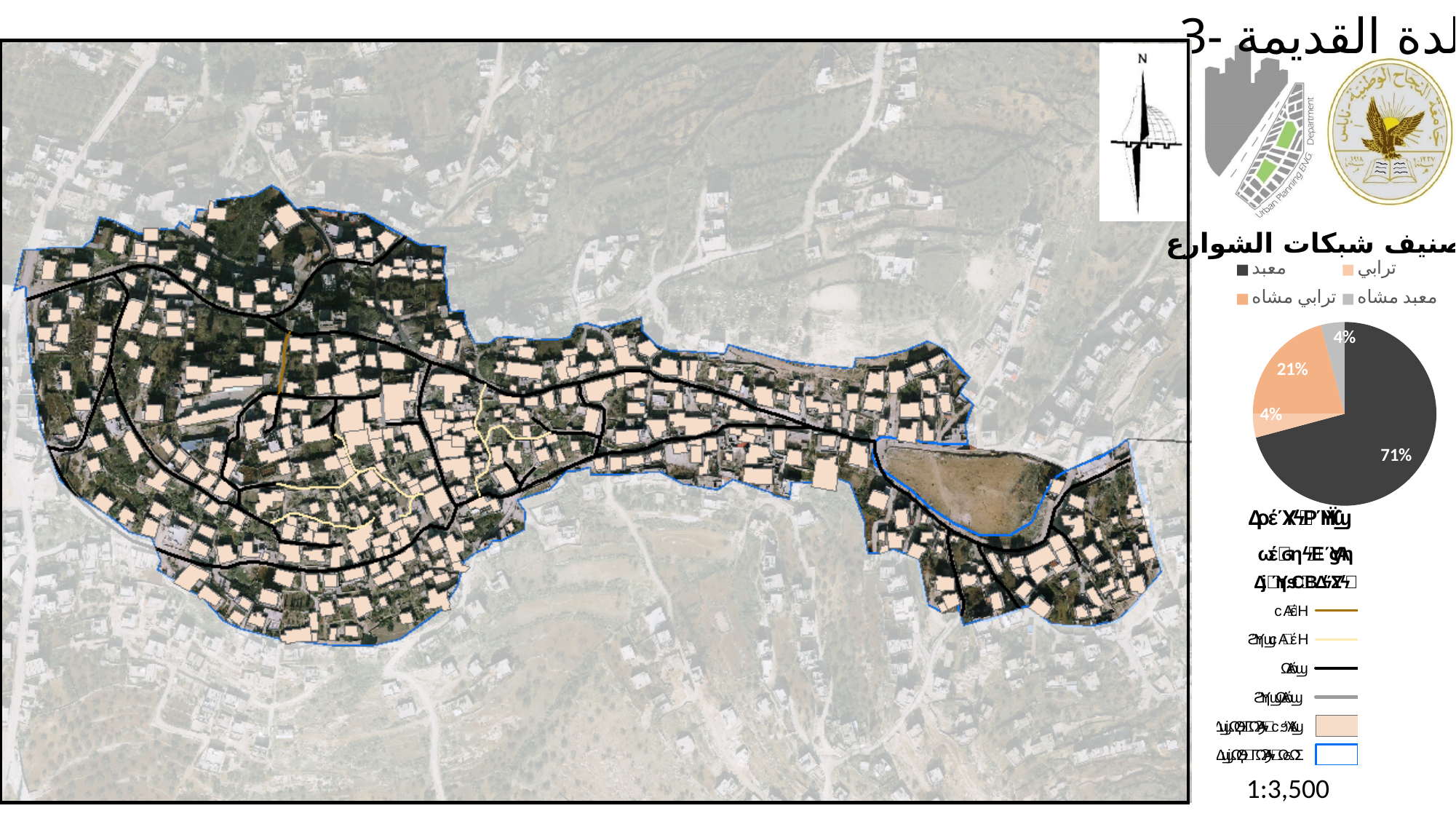
In the pie chart, what percentage is shown for ترابي مشاه? 21% Which is larger in the pie chart, معبد or ترابي? معبد In the pie chart, what percentage is shown for معبد مشاه? 4% What is the difference in percentage points between the معبد slice and the ترابي slice? 67 Which category has the largest slice in the pie chart? معبد How many entries does the pie chart's legend list? 4 What share of the pie does the معبد slice represent? 71% What kind of chart is shown on the right side of the slide? pie chart In the pie chart, what percentage is shown for ترابي? 4% In the pie chart, what percentage is shown for معبد? 71% What colour is the معبد slice in the pie chart? dark gray How many slices does the pie chart have? 4